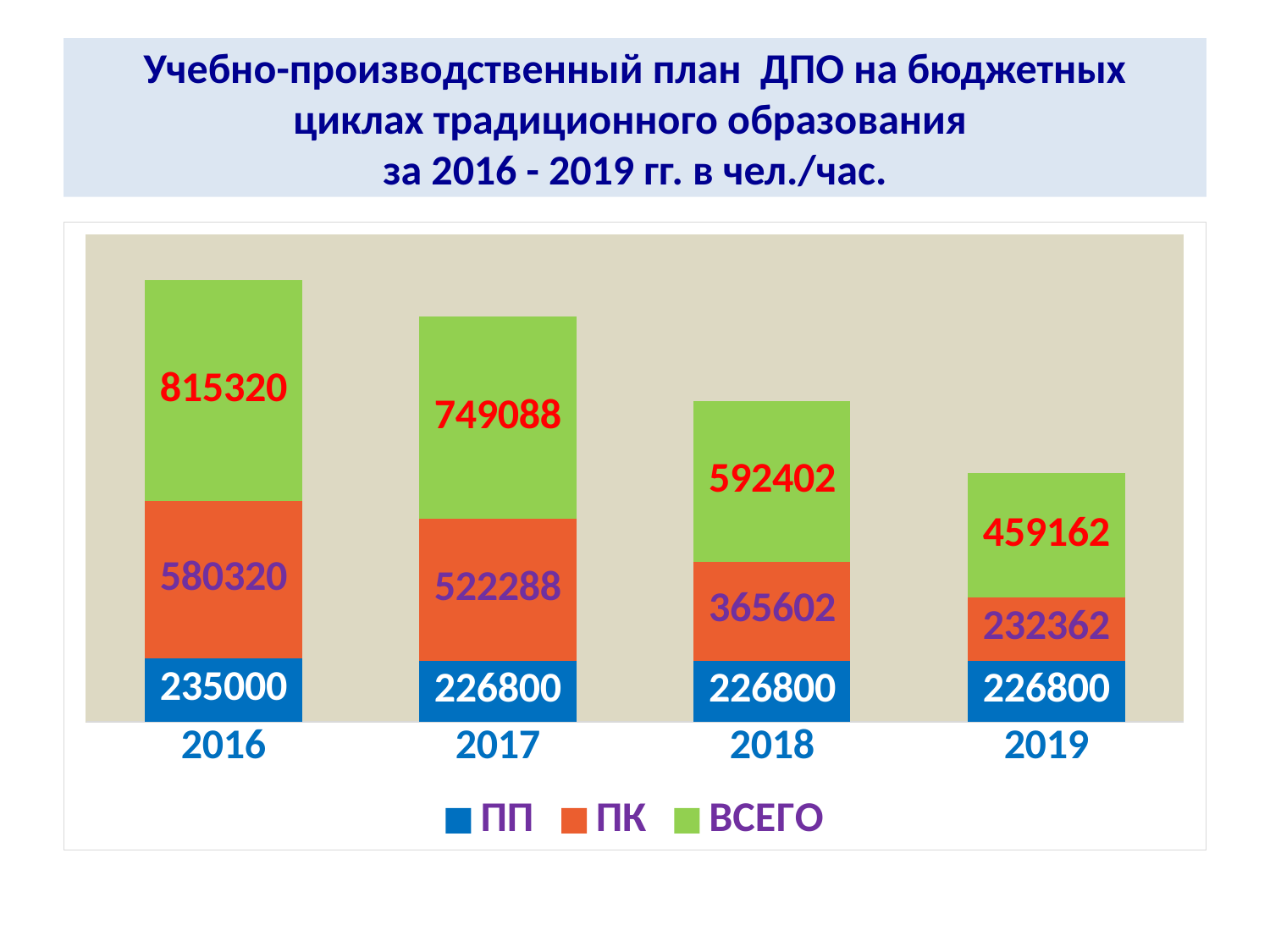
How many years are shown on the x axis? 4 What is the value of ПК for 2019? 232362 What is the difference between the ПК values for 2017 and 2018? 156686 Do the ВСЕГО values rise or fall from 2016 to 2019? fall Which is larger, the ПК value for 2017 or the ПК value for 2018? 2017 Which year has the lowest ПК value? 2019 What is the difference between the ВСЕГО values for 2016 and 2019? 356158 What is the value of ПП for 2016? 235000 Which year has the highest ВСЕГО value? 2016 How many series does the legend list? 3 What is the value of ВСЕГО for 2016? 815320 What is the value of ПК for 2018? 365602